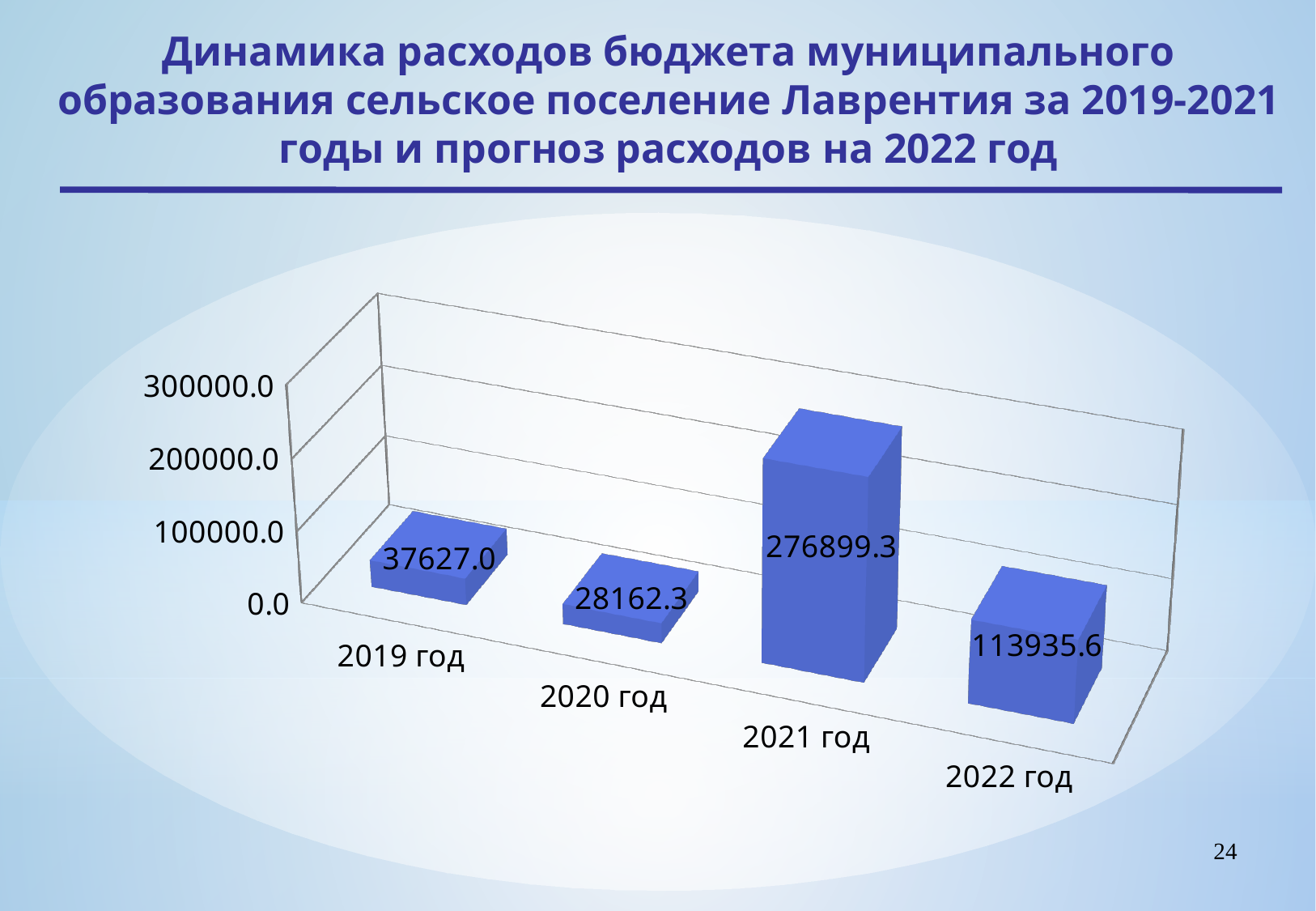
What is the difference between the values for 2021 год and 2022 год? 162963.7 Which is larger, the value for 2022 год or the value for 2019 год? 2022 год What is the value for 2019 год? 37627.0 Which year has the highest value? 2021 год What is the difference between the values for 2019 год and 2020 год? 9464.7 What is the value for 2021 год? 276899.3 What kind of chart is shown on the slide? bar chart Is the value for 2021 год greater or less than 200000.0? greater How many years are shown on the chart? 4 Which year has the lowest value? 2020 год What is the value for 2020 год? 28162.3 What is the value for 2022 год? 113935.6